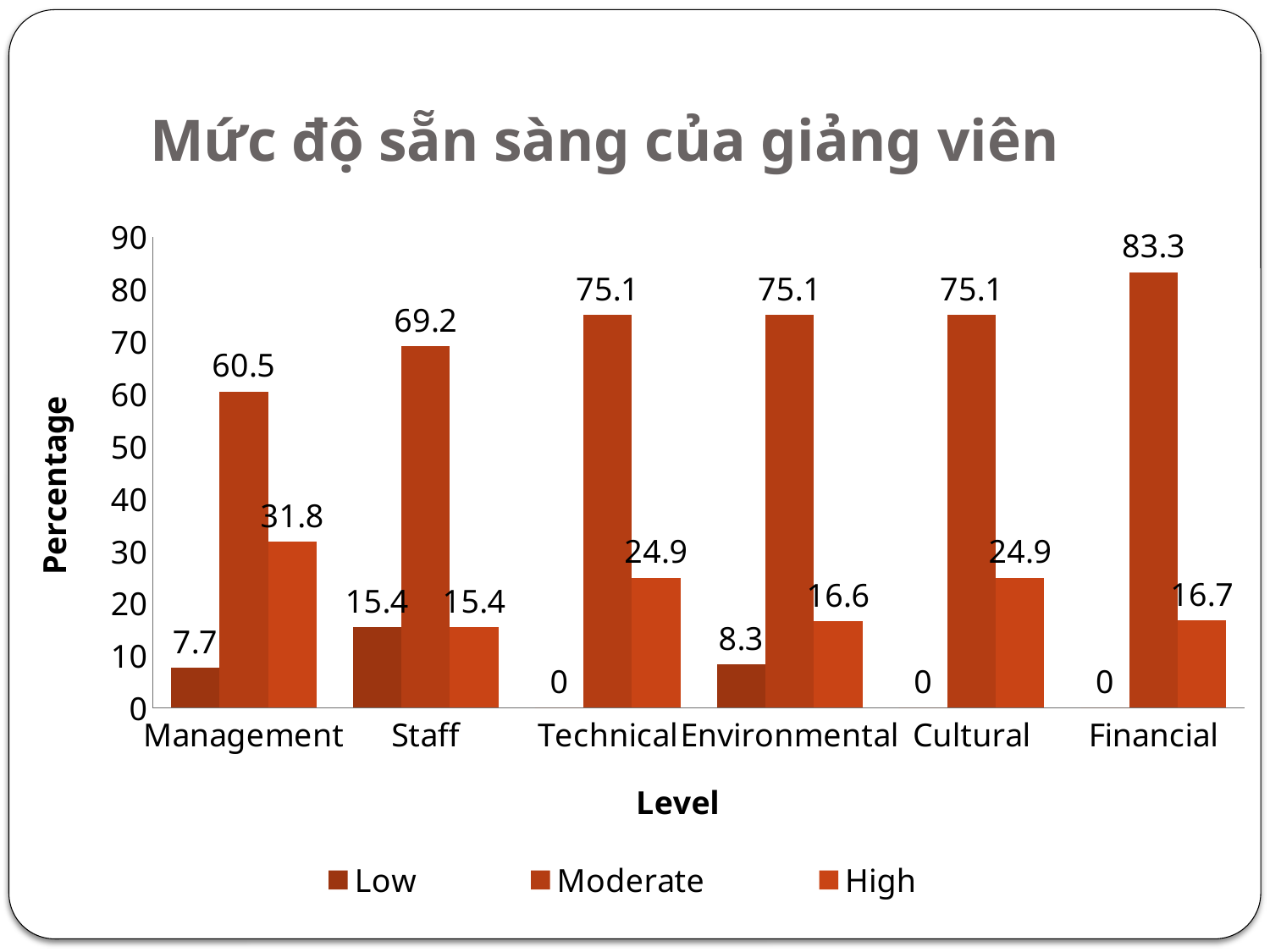
What is the Moderate value for Management? 60.5 How many series does the legend list? 3 Which is larger, the High value for Management or the High value for Staff? Management Which category has the highest High value? Management Is the Moderate value for Staff greater or less than 60? greater Which category has the lowest High value? Staff Which category has the highest Moderate value? Financial What is the High value for Technical? 24.9 What is the Low value for Environmental? 8.3 What kind of chart is shown on the slide? Bar chart How many categories are shown on the x axis? 6 What is the difference between the Moderate and High values for Financial? 66.6